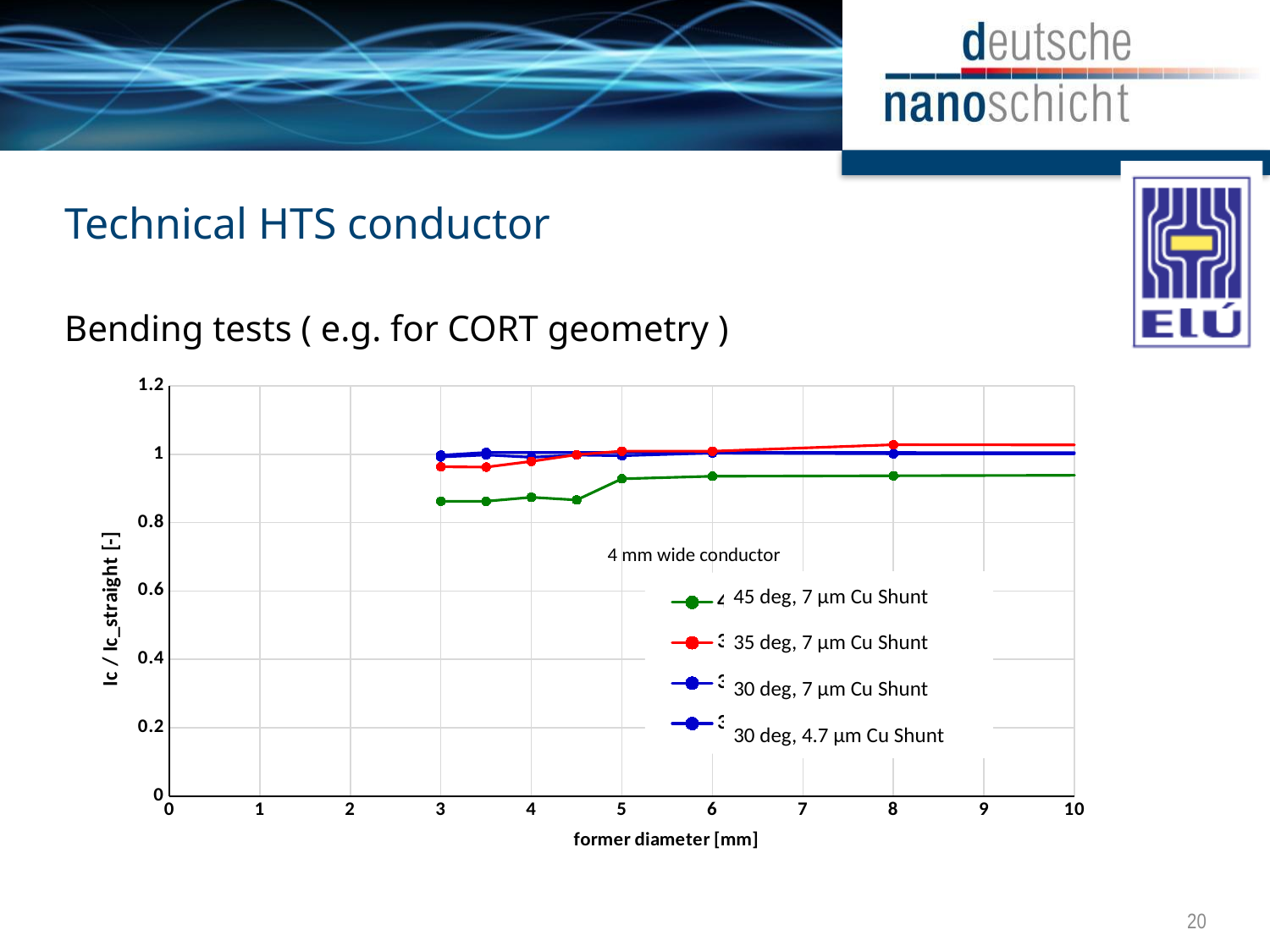
Does the 45 deg, 7 µm Cu Shunt series generally rise or fall as the former diameter increases? rise At a former diameter of 4 mm, which is larger: the value for the 45 deg, 7 µm Cu Shunt series or the 35 deg, 7 µm Cu Shunt series? 35 deg, 7 µm Cu Shunt What is the title of the x axis? former diameter [mm] Is the value for the 45 deg, 7 µm Cu Shunt series at a former diameter of 3 mm greater or less than 0.8? greater How many series does the legend list? 4 Is the value for the 45 deg, 7 µm Cu Shunt series at a former diameter of 3 mm greater or less than 1? less What is the highest value shown on the y axis? 1.2 What kind of chart is shown on the slide? line chart How many data points are plotted for the 45 deg, 7 µm Cu Shunt series? 7 Is the value for the 35 deg, 7 µm Cu Shunt series at a former diameter of 3 mm greater or less than 0.8? greater What is the title of the y axis? Ic / Ic_straight [-] At a former diameter of 3 mm, which series has the lowest value? 45 deg, 7 µm Cu Shunt